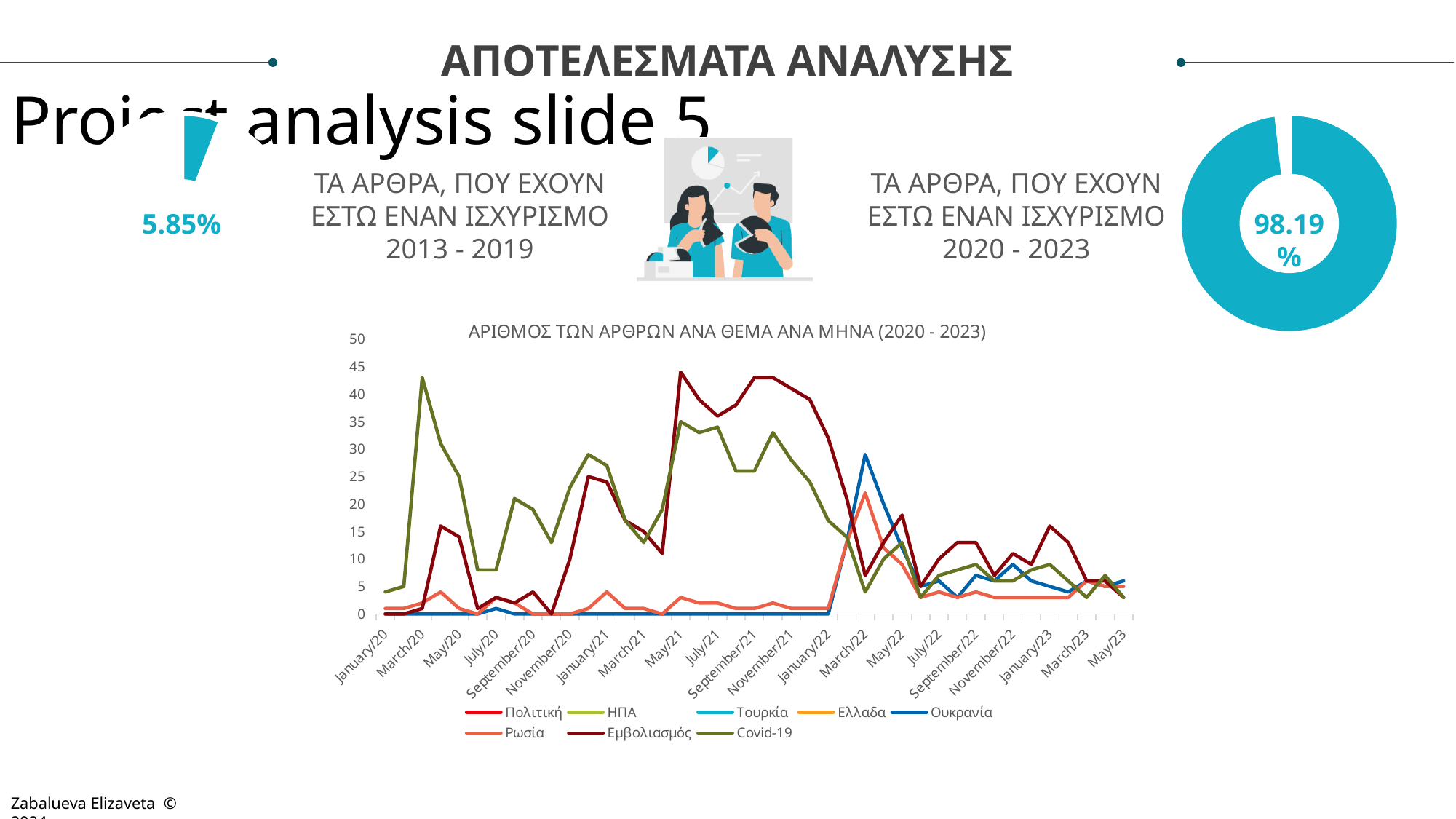
In the line chart, is the value for Ουκρανία in January/22 greater or less than 5? less How many series does the legend of the line chart list? 8 In the line chart, is the value for Covid-19 in March/20 greater or less than 40? greater In the line chart, which is larger in March/20: the value for Covid-19 or the value for Εμβολιασμός? Covid-19 In the line chart, does the Εμβολιασμός series rise or fall from September/21 to January/22? fall What is the title of the line chart on the slide? ΑΡΙΘΜΟΣ ΤΩΝ ΑΡΘΡΩΝ ΑΝΑ ΘΕΜΑ ΑΝΑ ΜΗΝΑ (2020 - 2023) What kind of chart is the chart titled "ΑΡΙΘΜΟΣ ΤΩΝ ΑΡΘΡΩΝ ΑΝΑ ΘΕΜΑ ΑΝΑ ΜΗΝΑ (2020 - 2023)"? line chart In the line chart, which series has the highest value in May/21? Εμβολιασμός What percentage is shown in the donut chart on the right of the slide (articles with at least one claim, 2020 - 2023)? 98.19% In the line chart, is the value for Ουκρανία in March/22 greater or less than 25? greater What percentage is shown next to the pie chart on the left of the slide (articles with at least one claim, 2013 - 2019)? 5.85%